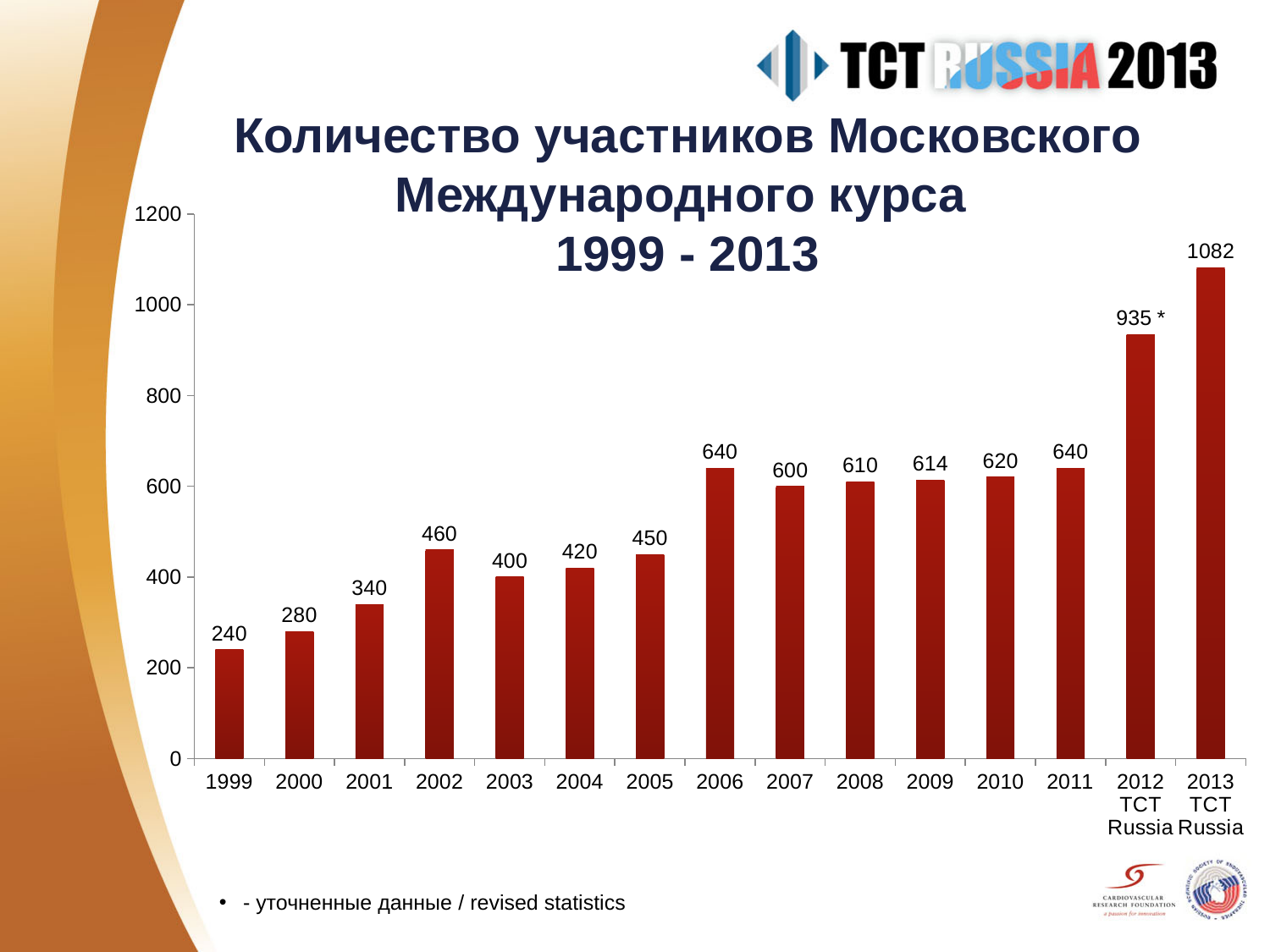
What is the difference between the values for 2002 and 2003? 60 Which is larger, the value for 2005 or the value for 2004? 2005 Do the values generally rise or fall from 1999 to 2013? rise What is the value for 2009? 614 What value is labelled on the bar for 2012 TCT Russia? 935 * What is the difference between the values for 2013 TCT Russia and 2012 TCT Russia? 147 Which year has the lowest number of participants? 1999 What kind of chart is shown on the slide? bar chart Is the value for 2011 greater or less than 800? less What is the number of participants shown for 1999? 240 Which year has the highest number of participants? 2013 TCT Russia How many years (bars) are shown on the chart? 15